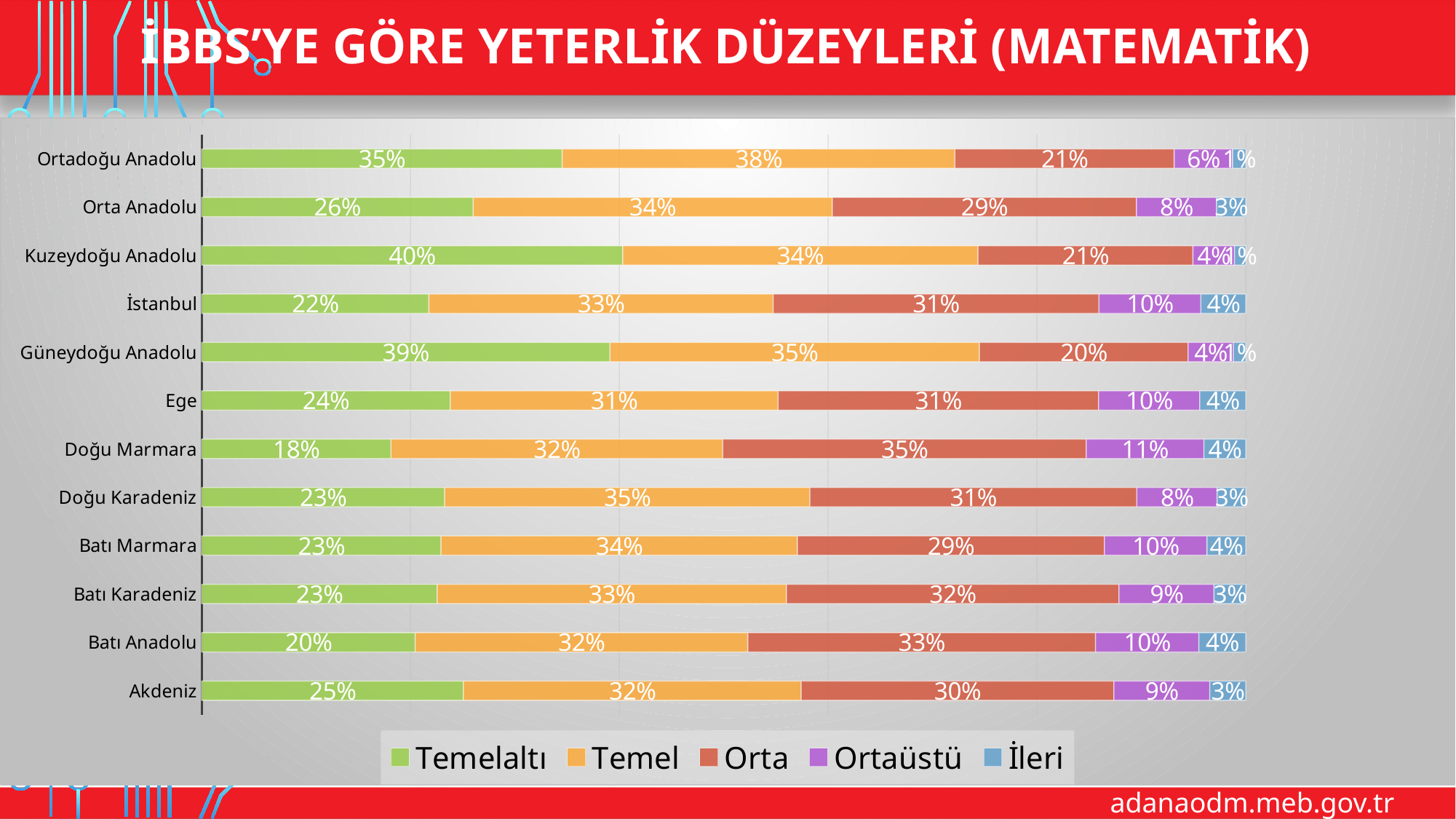
What is the Ortaüstü value for İstanbul? 10% Which region has the highest Temelaltı value? Kuzeydoğu Anadolu Which region has the lowest Temelaltı value? Doğu Marmara What is the difference between the Temelaltı values of Kuzeydoğu Anadolu and Doğu Marmara? 22% What is the Temelaltı value for Kuzeydoğu Anadolu? 40% What is the Orta value for Doğu Marmara? 35% Which is larger, the Orta value for Batı Anadolu or the Orta value for Akdeniz? Batı Anadolu How many series does the legend list? 5 What is the total of the stacked bar for İstanbul? 100% Which region has the highest Temel value? Ortadoğu Anadolu How many regions are shown on the chart? 12 What kind of chart is shown on the slide? Stacked bar chart